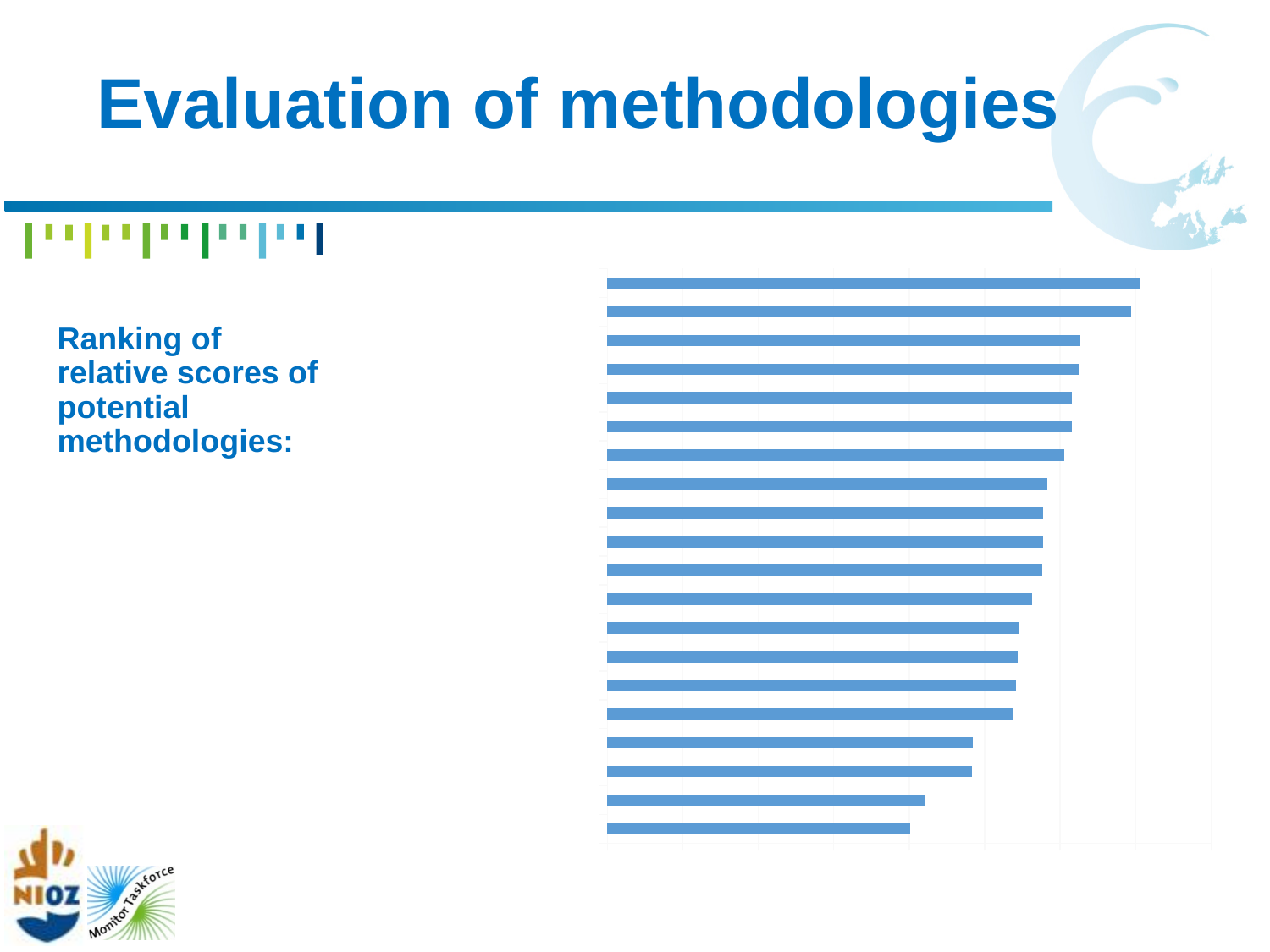
What kind of chart is shown on the slide? bar chart What colour are the bars in the chart? blue How many bars does the chart contain? 20 Does the chart display a legend? No Which bar is the longest in the chart? the top bar Are the bars horizontal or vertical? horizontal Which bar is the shortest in the chart? the bottom bar Do the bar lengths increase or decrease from the top of the chart to the bottom? decrease Is the topmost bar longer or shorter than the bottom bar? longer